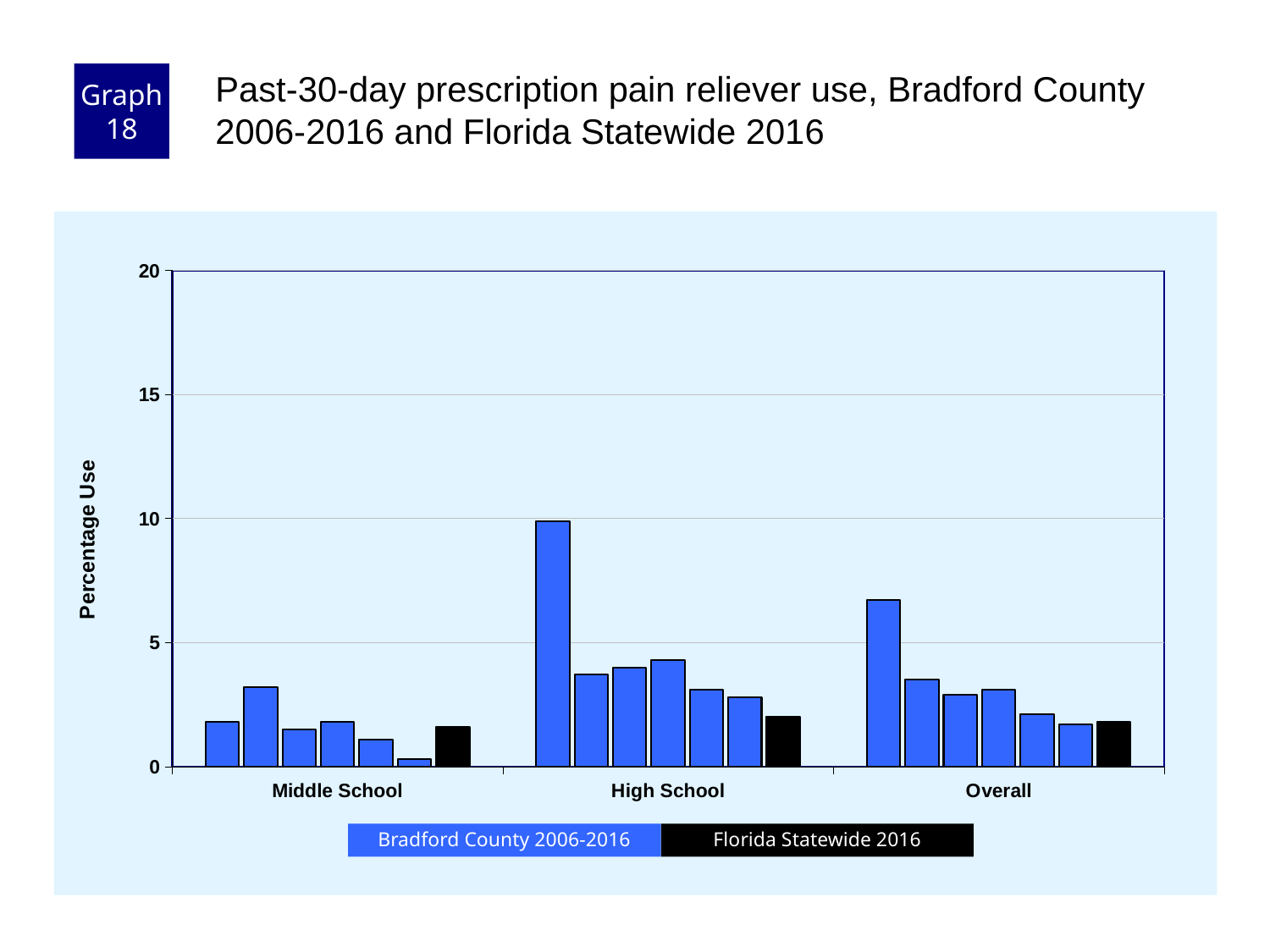
Is the value of the tallest bar in the High School group greater or less than 15? less Is the Florida Statewide 2016 value for High School greater or less than 5? less Which category group contains the tallest bar on the chart? High School Which is larger: the tallest bar in the High School group or the tallest bar in the Overall group? High School What kind of chart is shown on the slide? Bar chart What is the label on the y axis? Percentage Use Is the value of the tallest bar in the Middle School group greater or less than 5? less What are the two series named in the legend? Bradford County 2006-2016 and Florida Statewide 2016 How many series does the legend list? 2 How many categories are shown on the x axis of the chart? 3